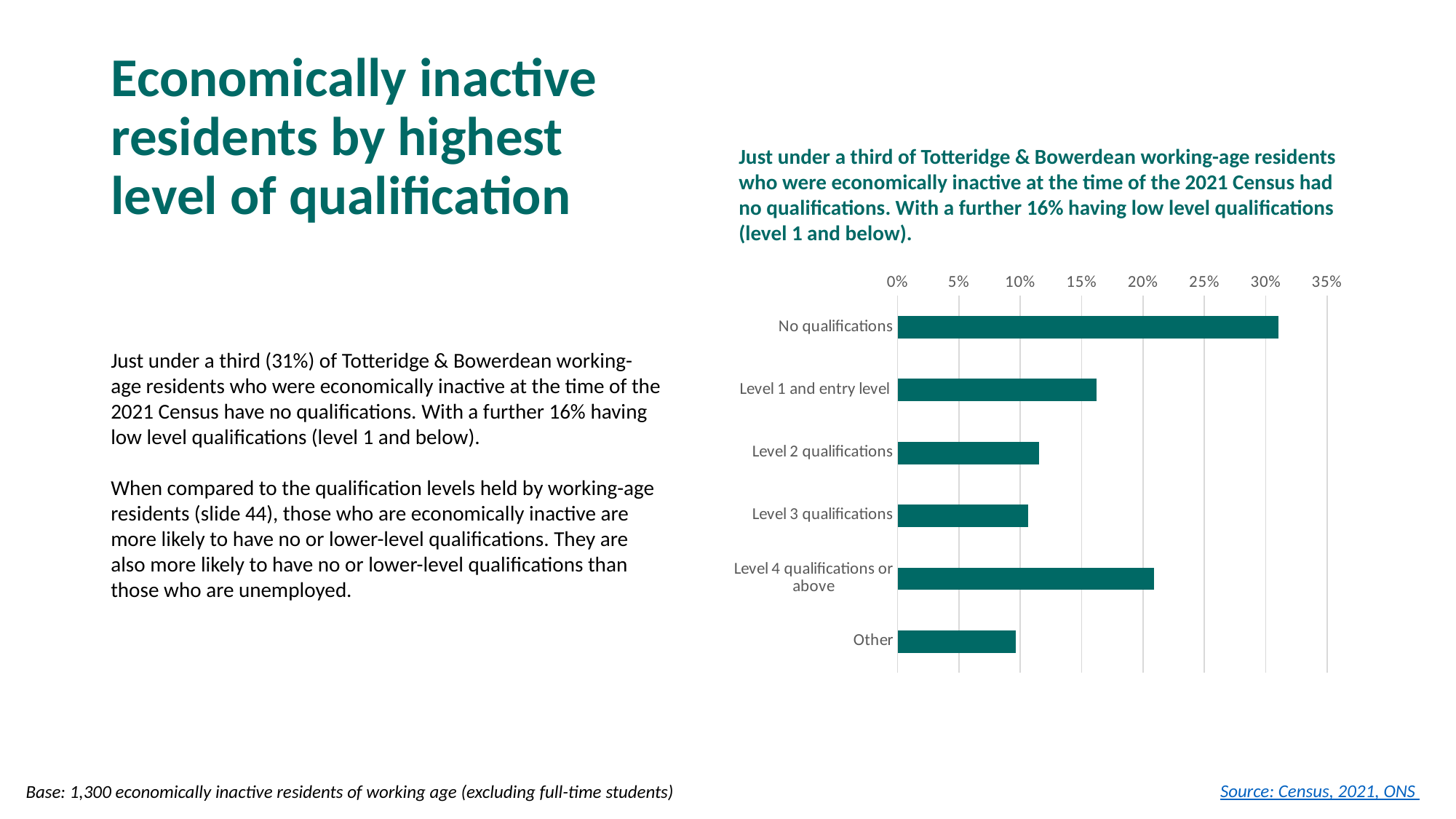
Which is larger, the value for Level 4 qualifications or above or the value for Level 1 and entry level? Level 4 qualifications or above Is the value for No qualifications greater or less than 30%? greater Is the value for Level 3 qualifications greater or less than 15%? less Which qualification category has the lowest value in the chart? Other How many qualification categories are plotted in the chart? 6 Which qualification category has the highest value in the chart? No qualifications What kind of chart is shown on the slide? bar chart What is the highest value shown on the chart's percentage axis? 35% Is the value for Level 1 and entry level greater or less than 15%? greater Which is larger, the value for No qualifications or the value for Level 4 qualifications or above? No qualifications